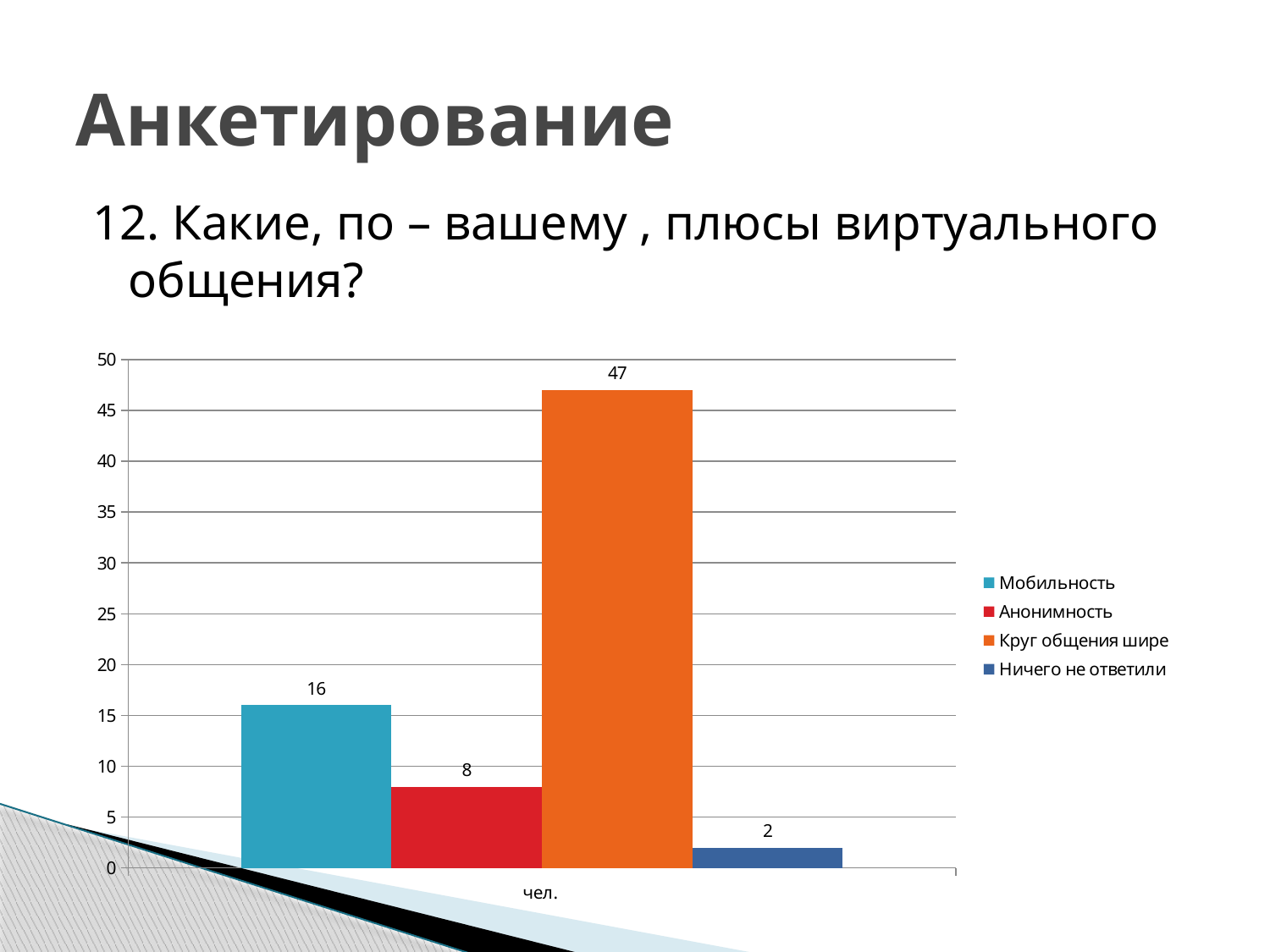
What is the label shown on the x axis of the chart? чел. What kind of chart is shown on the slide? Bar chart What is the value for Ничего не ответили? 2 What is the difference between the values for Мобильность and Анонимность? 8 What is the value for Анонимность? 8 What is the value for Мобильность? 16 Which series has the lowest value? Ничего не ответили How many series does the legend list? 4 What is the value for Круг общения шире? 47 Which is larger, the value for Мобильность or the value for Анонимность? Мобильность Which series has the highest value? Круг общения шире What is the difference between the values for Круг общения шире and Мобильность? 31